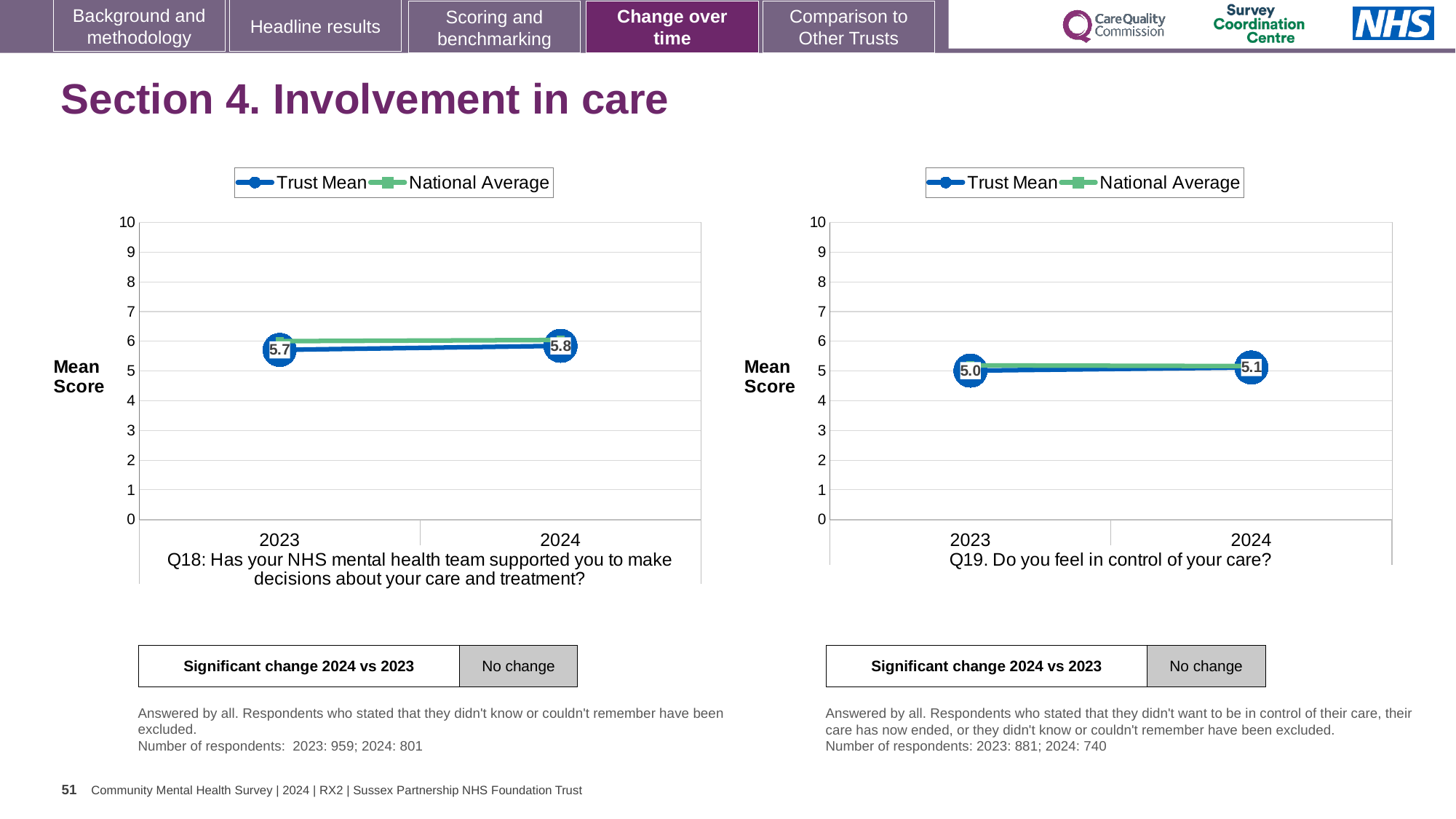
How many series does the legend of the Q19 chart on the right list? 2 In the Q19 chart on the right, what is the Trust Mean score for 2023? 5.0 In the Q18 chart on the left, is the National Average for 2024 greater or less than 7? less In the Q18 chart on the left, by how much did the Trust Mean change from 2023 to 2024? 0.1 In the Q19 chart on the right, what is the Trust Mean score for 2024? 5.1 In the Q18 chart on the left, what is the Trust Mean score for 2023? 5.7 What kind of chart is the Q19 chart on the right? line chart In the Q19 chart on the right, is the National Average for 2023 greater or less than 4? greater In the Q19 chart on the right, does the Trust Mean rise or fall from 2023 to 2024? rise How many years are plotted on the x axis of the Q18 chart on the left? 2 In the Q18 chart on the left, what is the Trust Mean score for 2024? 5.8 In the Q18 chart on the left, which series is shown in green? National Average